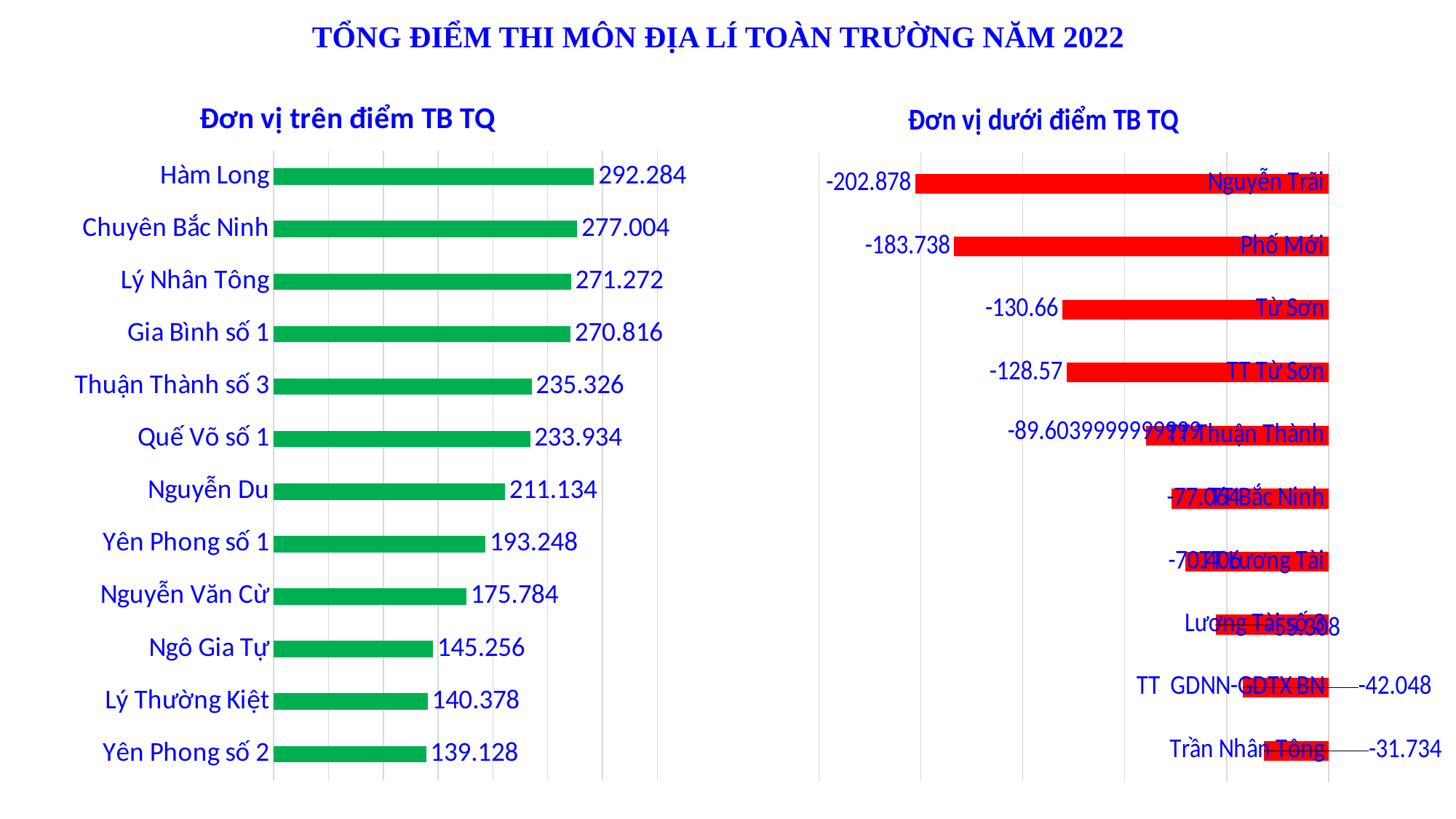
In the chart titled 'Đơn vị dưới điểm TB TQ', what is the value for Nguyễn Trãi? -202.878 How many categories are shown in the chart titled 'Đơn vị trên điểm TB TQ'? 12 In the chart titled 'Đơn vị trên điểm TB TQ', what is the difference between the values for Hàm Long and Chuyên Bắc Ninh? 15.28 In the chart titled 'Đơn vị trên điểm TB TQ', what is the value for Hàm Long? 292.284 In the chart titled 'Đơn vị dưới điểm TB TQ', what is the value for TT Từ Sơn? -128.57 In the chart titled 'Đơn vị trên điểm TB TQ', which is larger: the value for Thuận Thành số 3 or Quế Võ số 1? Thuận Thành số 3 What type of chart is the chart titled 'Đơn vị dưới điểm TB TQ'? Bar chart How many categories are shown in the chart titled 'Đơn vị dưới điểm TB TQ'? 10 In the chart titled 'Đơn vị trên điểm TB TQ', which category has the highest value? Hàm Long In the chart titled 'Đơn vị trên điểm TB TQ', which category has the lowest value? Yên Phong số 2 In the chart titled 'Đơn vị dưới điểm TB TQ', what is the value for Trần Nhân Tông? -31.734 In the chart titled 'Đơn vị trên điểm TB TQ', what is the value for Nguyễn Du? 211.134